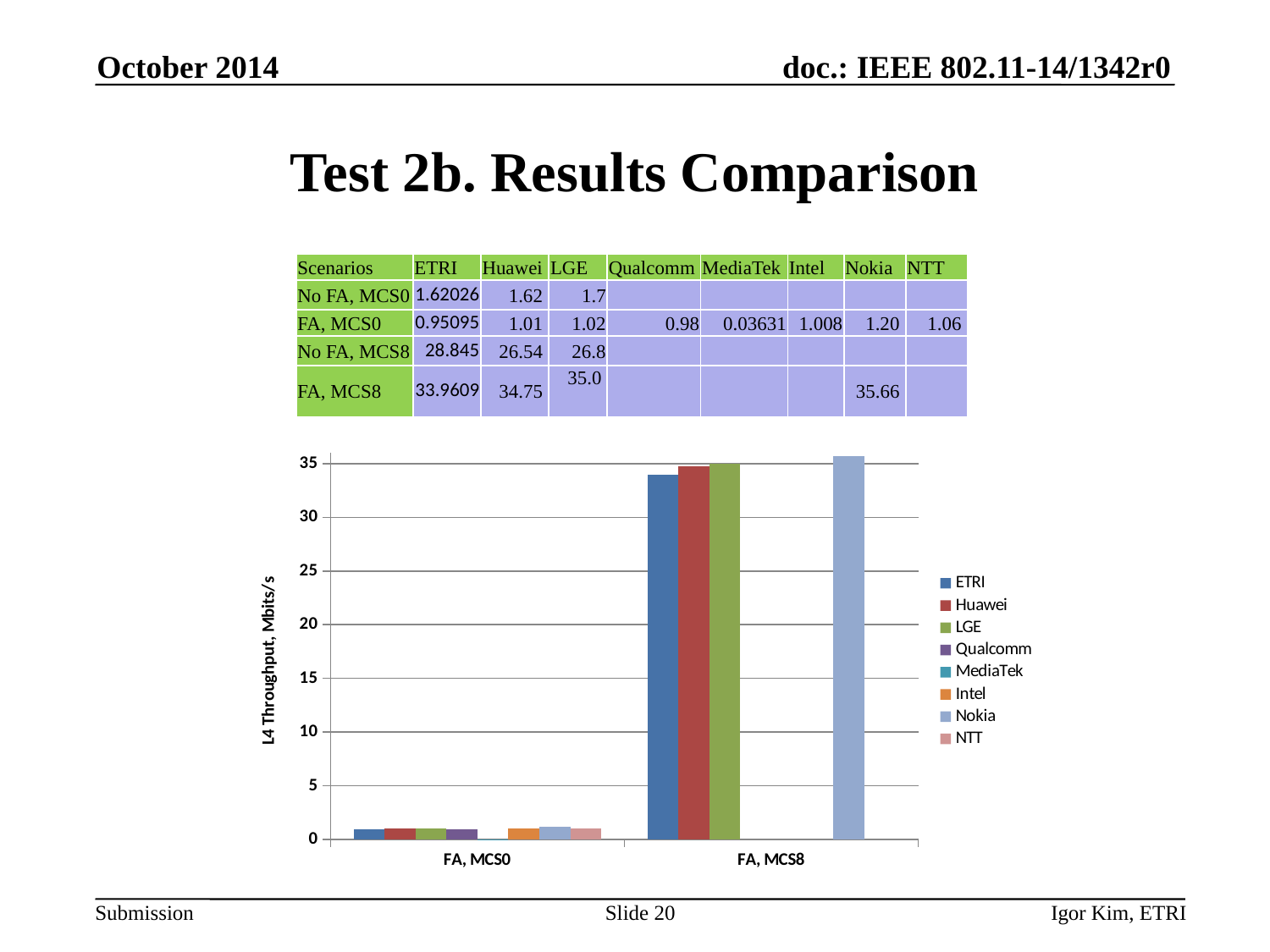
Is the Huawei value for FA, MCS0 greater or less than 5? less How many categories are shown on the x axis of the chart? 2 Is the ETRI bar larger for FA, MCS0 or for FA, MCS8? FA, MCS8 What is the y-axis title of the chart? L4 Throughput, Mbits/s Which series has the highest bar in the FA, MCS8 category? Nokia According to the table, what is the Nokia value for FA, MCS8? 35.66 According to the table, what is the difference between the LGE and Huawei values for FA, MCS8? 0.25 Which series has the lowest bar in the FA, MCS8 category? ETRI Is the ETRI value for FA, MCS8 greater or less than 30? greater How many series does the chart legend list? 8 Which series has the lowest bar in the FA, MCS0 category? MediaTek What kind of chart is shown on the slide? bar chart